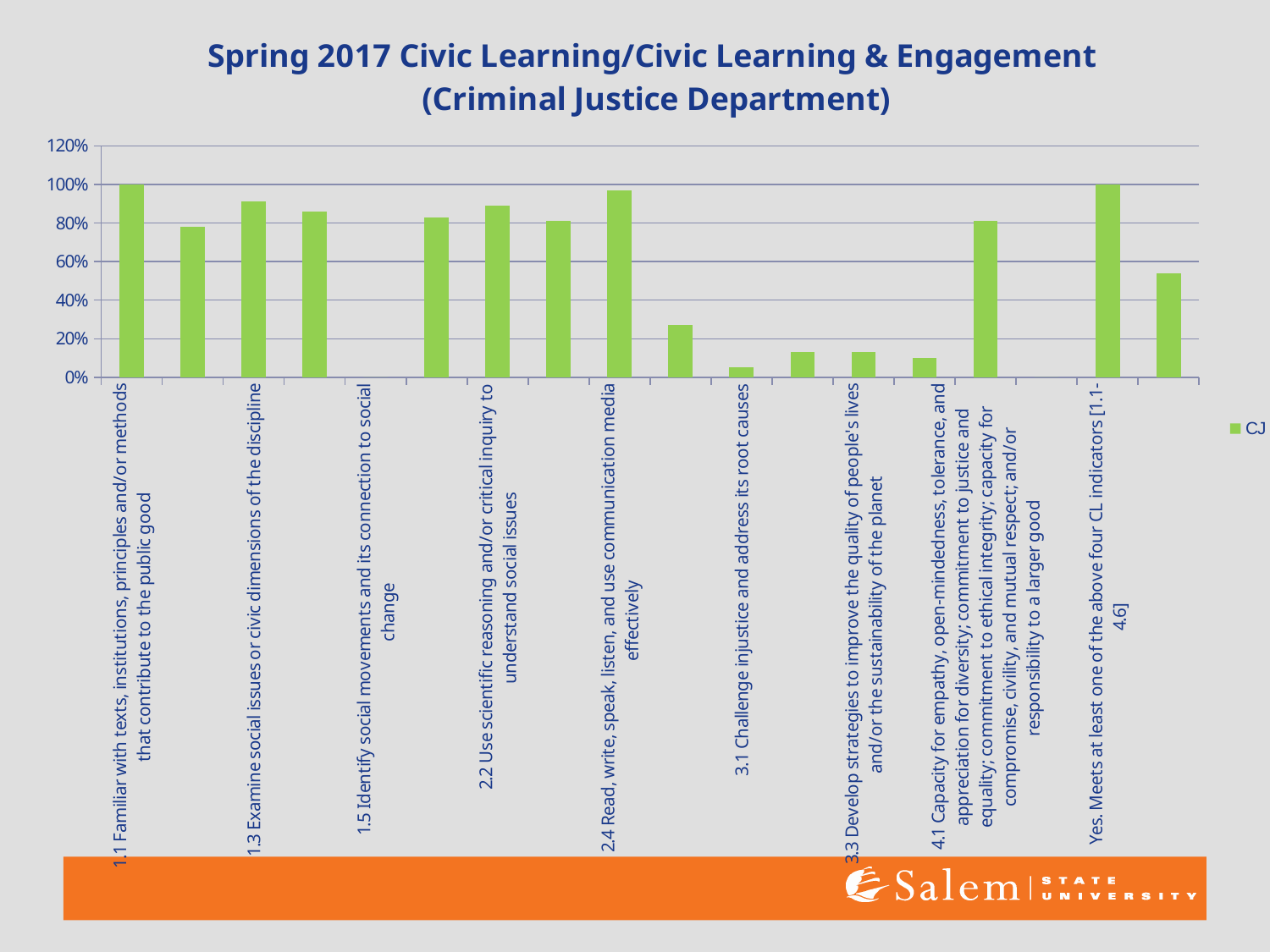
What kind of chart is shown on the slide? bar chart Is the value for '3.1 Challenge injustice and address its root causes' greater or less than 20%? less Is the value for '4.1 Capacity for empathy, open-mindedness, tolerance, and appreciation for diversity...' greater or less than 60%? greater What is the name of the series shown in the legend? CJ Which is larger: the value for '2.4 Read, write, speak, listen, and use communication media effectively' or the value for '3.1 Challenge injustice and address its root causes'? 2.4 Read, write, speak, listen, and use communication media effectively Is the value for '2.4 Read, write, speak, listen, and use communication media effectively' greater or less than 80%? greater What is the title of the chart? Spring 2017 Civic Learning/Civic Learning & Engagement (Criminal Justice Department) What is the value for 'Yes. Meets at least one of the above four CL indicators [1.1-4.6]'? 100% Which is larger: the value for '3.3 Develop strategies to improve the quality of people's lives and/or the sustainability of the planet' or the value for '1.3 Examine social issues or civic dimensions of the discipline'? 1.3 Examine social issues or civic dimensions of the discipline What is the value for '1.1 Familiar with texts, institutions, principles and/or methods that contribute to the public good'? 100% How many series does the legend list? 1